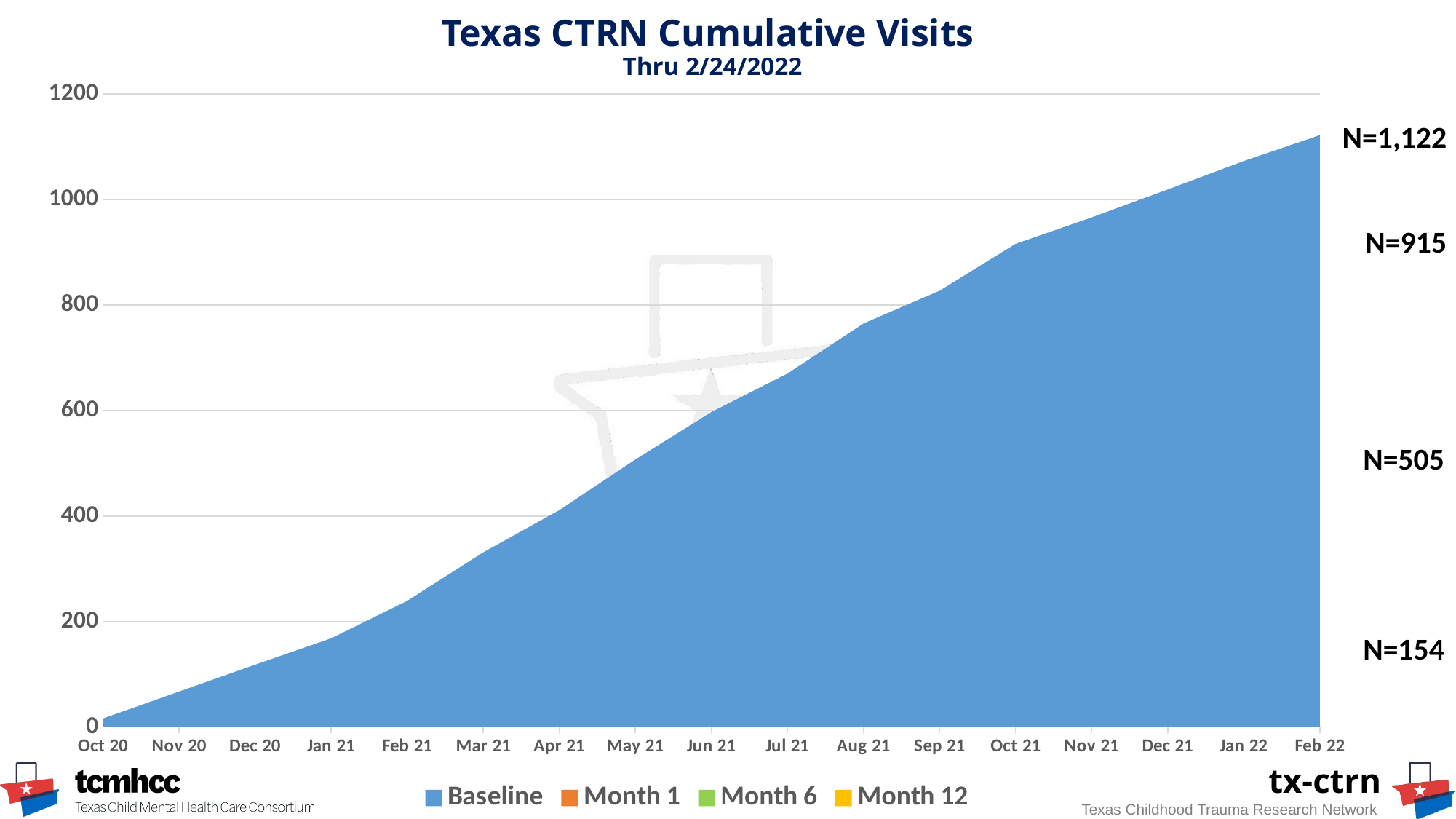
What N value is labelled at the top of the area at Feb 22? N=1,122 Is the value for Jan 21 greater or less than 200? less Which is larger, the value for Oct 21 or the value for Mar 21? Oct 21 Do the cumulative visits rise or fall from Oct 20 to Feb 22? rise What is the title of the chart? Texas CTRN Cumulative Visits Which month has the lowest cumulative visits? Oct 20 How many series does the legend list? 4 Which month has the highest cumulative visits? Feb 22 What kind of chart is shown on the slide? area chart How many months are shown along the x axis? 17 Is the value for Jan 22 greater or less than 1000? greater Is the value for Oct 21 greater or less than 800? greater